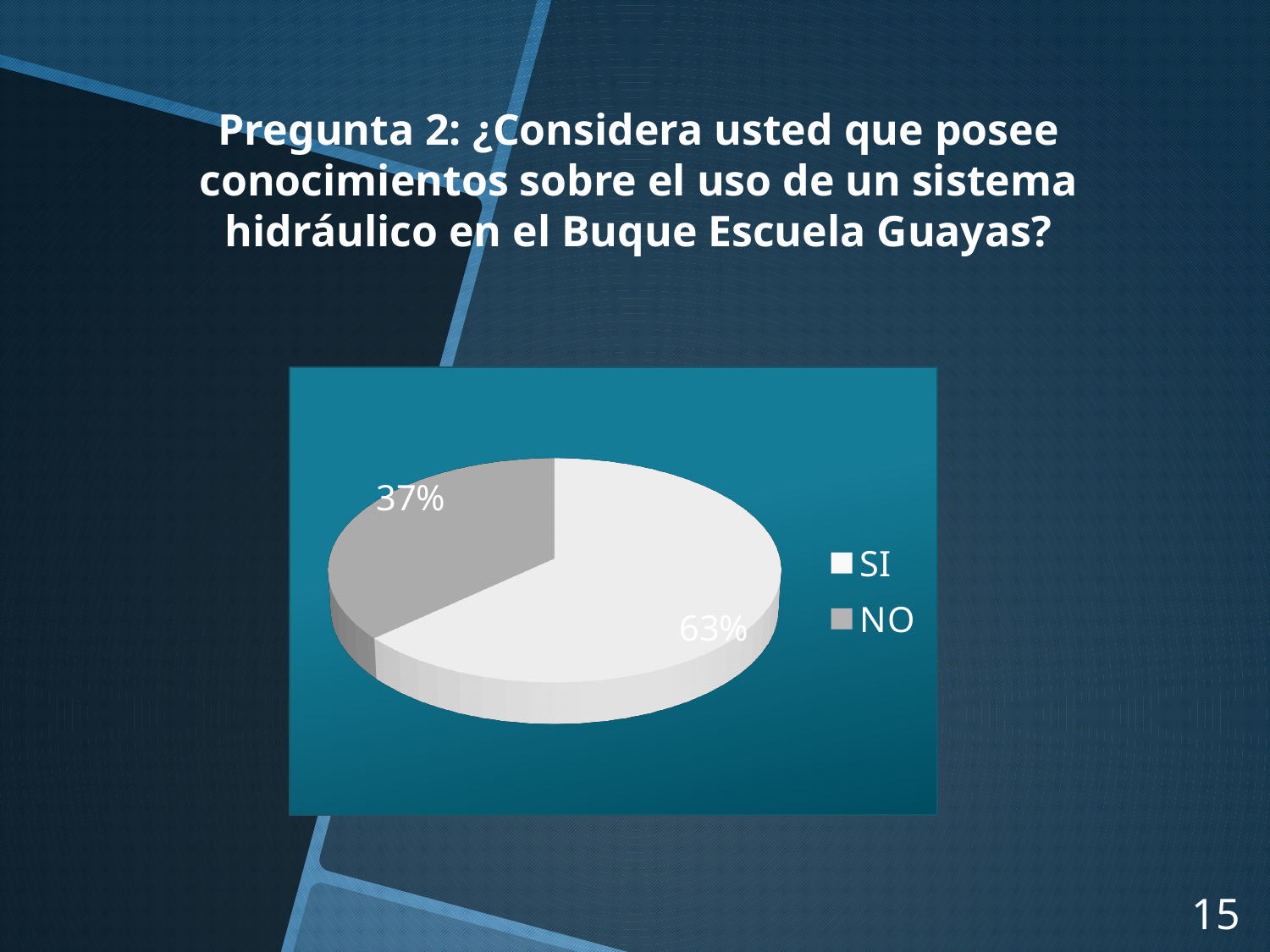
Which legend entry is shown in the darker grey colour? NO What share of the pie does the NO slice represent? 37% How many entries does the legend list? 2 What is the difference in percentage points between the SI and NO slices? 26 Which response has the largest share of the pie? SI What percentage of respondents answered NO? 37% Which is larger, the SI slice or the NO slice? SI What percentage of respondents answered SI? 63% Is the share for SI greater or less than 50%? greater How many slices does the pie chart have? 2 Which response has the smallest share of the pie? NO What kind of chart is shown on the slide? pie chart